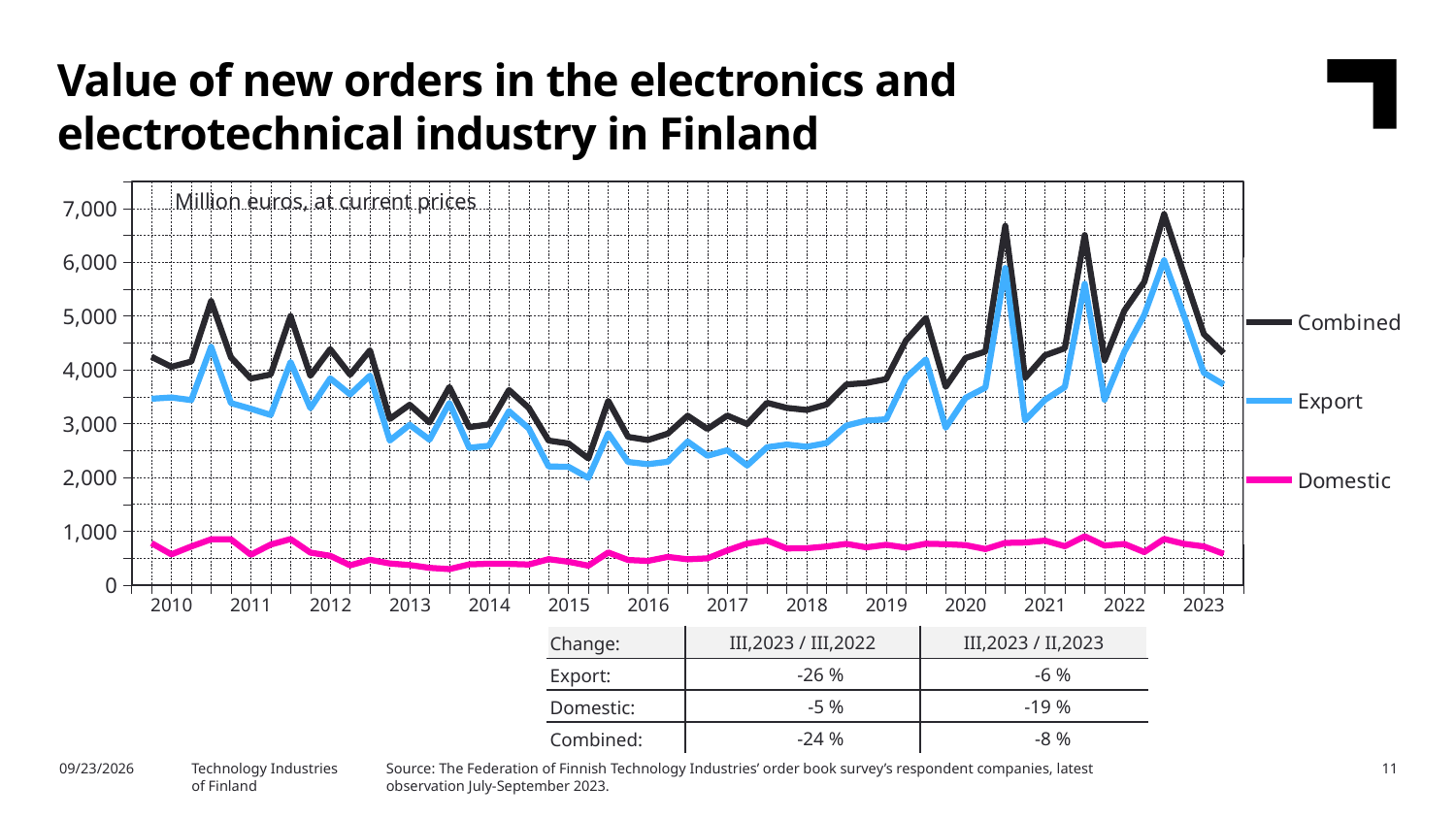
What kind of chart is shown on the slide? line chart How many years are labelled on the x axis? 14 Is the peak Combined value in 2022 greater or less than 6,000? greater How many series does the chart's legend list? 3 Is the Domestic value in 2023 greater or less than 1,000? less Is the peak Export value in 2022 greater or less than 5,000? greater Which series has the lowest values throughout the chart? Domestic What are the three series named in the chart's legend? Combined, Export, Domestic What unit is stated for the values in the chart? Million euros, at current prices Which series has the highest values throughout the chart? Combined Does the Combined series rise or fall from its 2022 peak to the end of 2023? fall